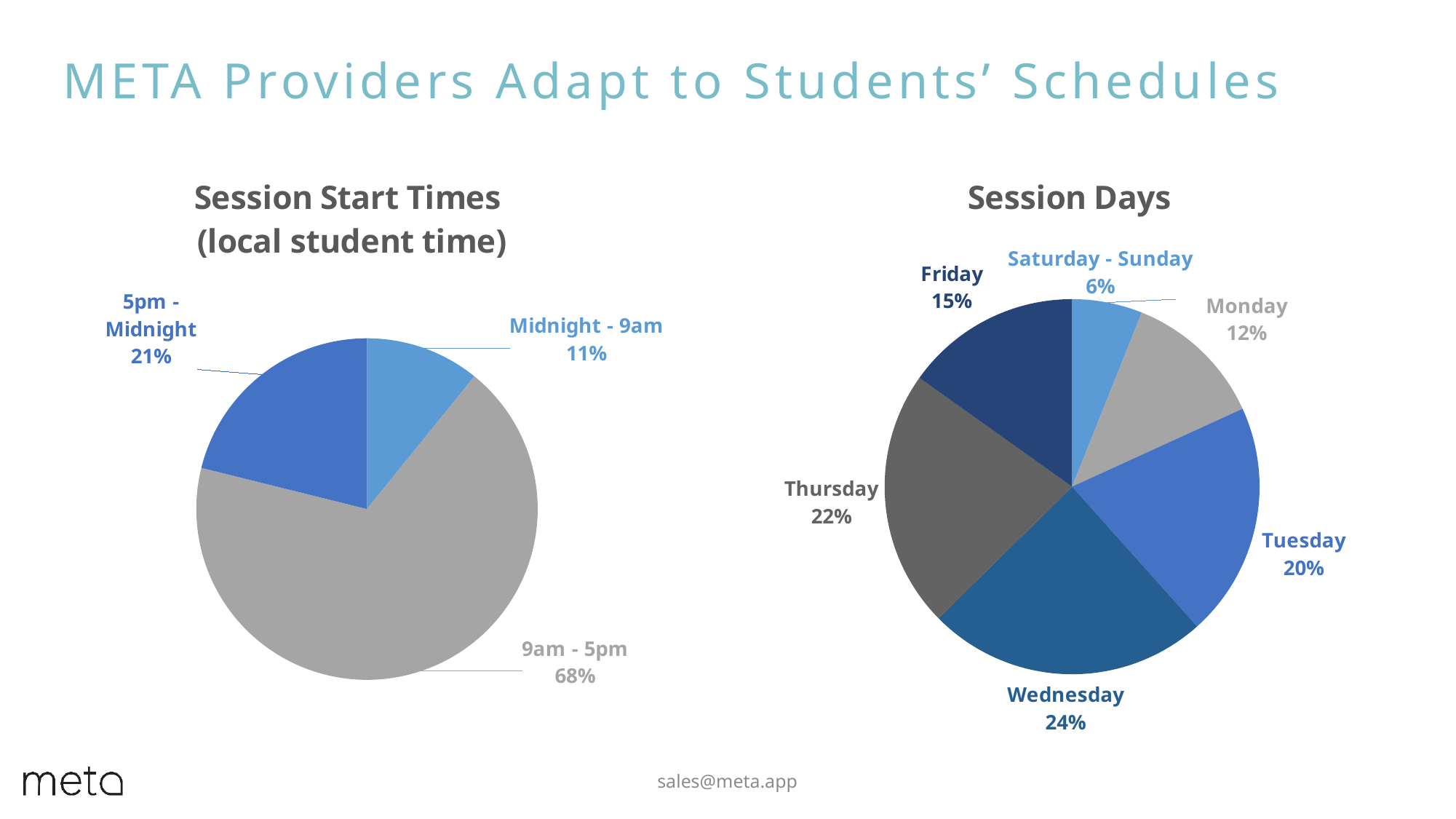
In the 'Session Days' chart, which has a larger share, Tuesday or Friday? Tuesday In the 'Session Start Times (local student time)' chart, what share of sessions start between Midnight and 9am? 11% In the 'Session Days' chart, what share of sessions take place on Wednesday? 24% In the 'Session Days' chart, what share of sessions take place on Saturday - Sunday? 6% What kind of chart is the 'Session Days' chart? Pie chart In the 'Session Days' chart, which day has the largest share of sessions? Wednesday In the 'Session Start Times (local student time)' chart, which start time slot has the smallest share? Midnight - 9am In the 'Session Start Times (local student time)' chart, how many start time slots are shown? 3 In the 'Session Days' chart, which category has the smallest share of sessions? Saturday - Sunday In the 'Session Days' chart, what is the difference in percentage points between Thursday and Monday? 10 In the 'Session Start Times (local student time)' chart, what share of sessions start between 9am and 5pm? 68% In the 'Session Start Times (local student time)' chart, which start time slot has the largest share? 9am - 5pm